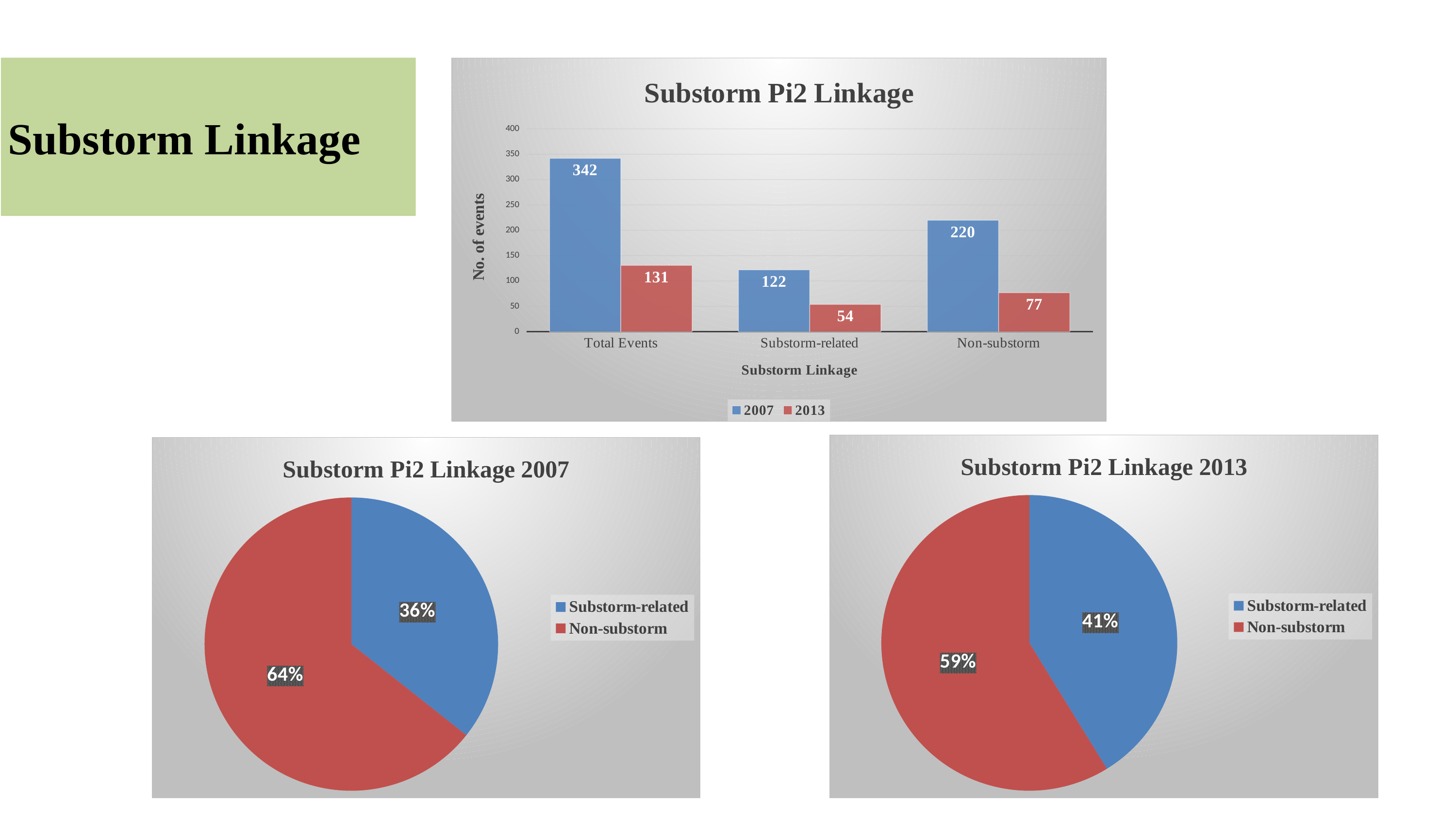
In the 'Substorm Pi2 Linkage 2013' pie chart, what share is Non-substorm? 59% In the 'Substorm Pi2 Linkage' bar chart, what is the difference between the 2007 and 2013 values for Total Events? 211 In the 'Substorm Pi2 Linkage' bar chart, how many categories are shown on the x axis? 3 In the 'Substorm Pi2 Linkage' bar chart, what is the value for Substorm-related in 2013? 54 What kind of chart is 'Substorm Pi2 Linkage' at the top of the slide? Bar chart In the 'Substorm Pi2 Linkage' bar chart, which category has the lowest value for the 2013 series? Substorm-related In the 'Substorm Pi2 Linkage' bar chart, what is the value for Total Events in 2007? 342 In the 'Substorm Pi2 Linkage' bar chart, what is the y-axis title? No. of events In the 'Substorm Pi2 Linkage' bar chart, how many series does the legend list? 2 In the 'Substorm Pi2 Linkage 2007' pie chart, what share is Substorm-related? 36% In the 'Substorm Pi2 Linkage' bar chart, which is larger: the 2013 value for Non-substorm or the 2013 value for Substorm-related? Non-substorm In the 'Substorm Pi2 Linkage' bar chart, what is the value for Non-substorm in 2007? 220